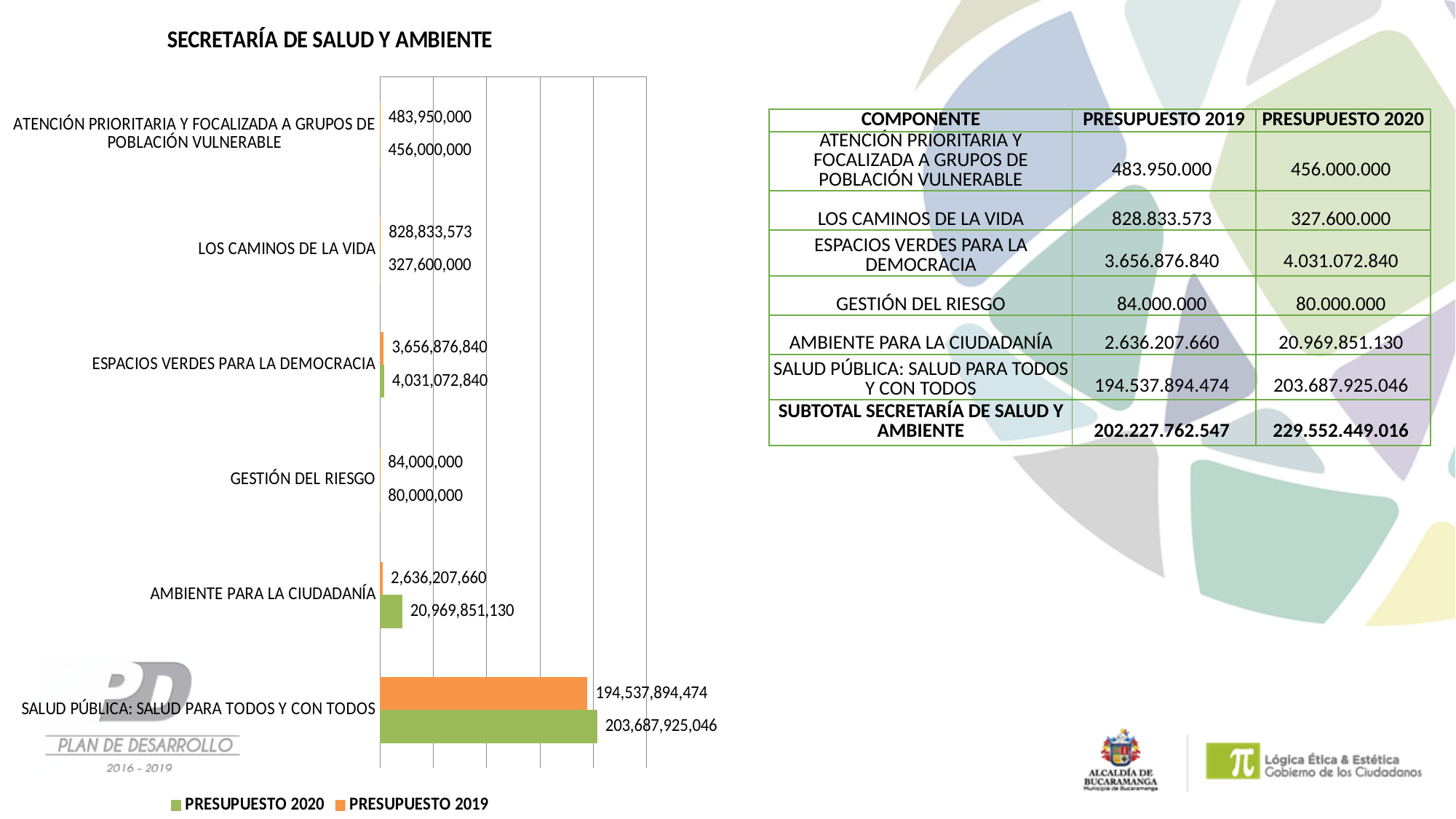
Which category has the highest PRESUPUESTO 2020 value? SALUD PÚBLICA: SALUD PARA TODOS Y CON TODOS For LOS CAMINOS DE LA VIDA, which is larger: the PRESUPUESTO 2019 value or the PRESUPUESTO 2020 value? PRESUPUESTO 2019 How many categories are plotted in the chart? 6 What is the difference between the PRESUPUESTO 2020 and PRESUPUESTO 2019 values for SALUD PÚBLICA: SALUD PARA TODOS Y CON TODOS? 9,150,030,572 Which category has the lowest PRESUPUESTO 2019 value? GESTIÓN DEL RIESGO What is the PRESUPUESTO 2019 value for LOS CAMINOS DE LA VIDA? 828,833,573 What is the PRESUPUESTO 2020 value for AMBIENTE PARA LA CIUDADANÍA? 20,969,851,130 What is the PRESUPUESTO 2020 value for ESPACIOS VERDES PARA LA DEMOCRACIA? 4,031,072,840 Which colour represents PRESUPUESTO 2020 in the chart? Green How many series does the chart legend list? 2 What is the difference between the PRESUPUESTO 2019 and PRESUPUESTO 2020 values for GESTIÓN DEL RIESGO? 4,000,000 What type of chart is shown on the slide? Bar chart